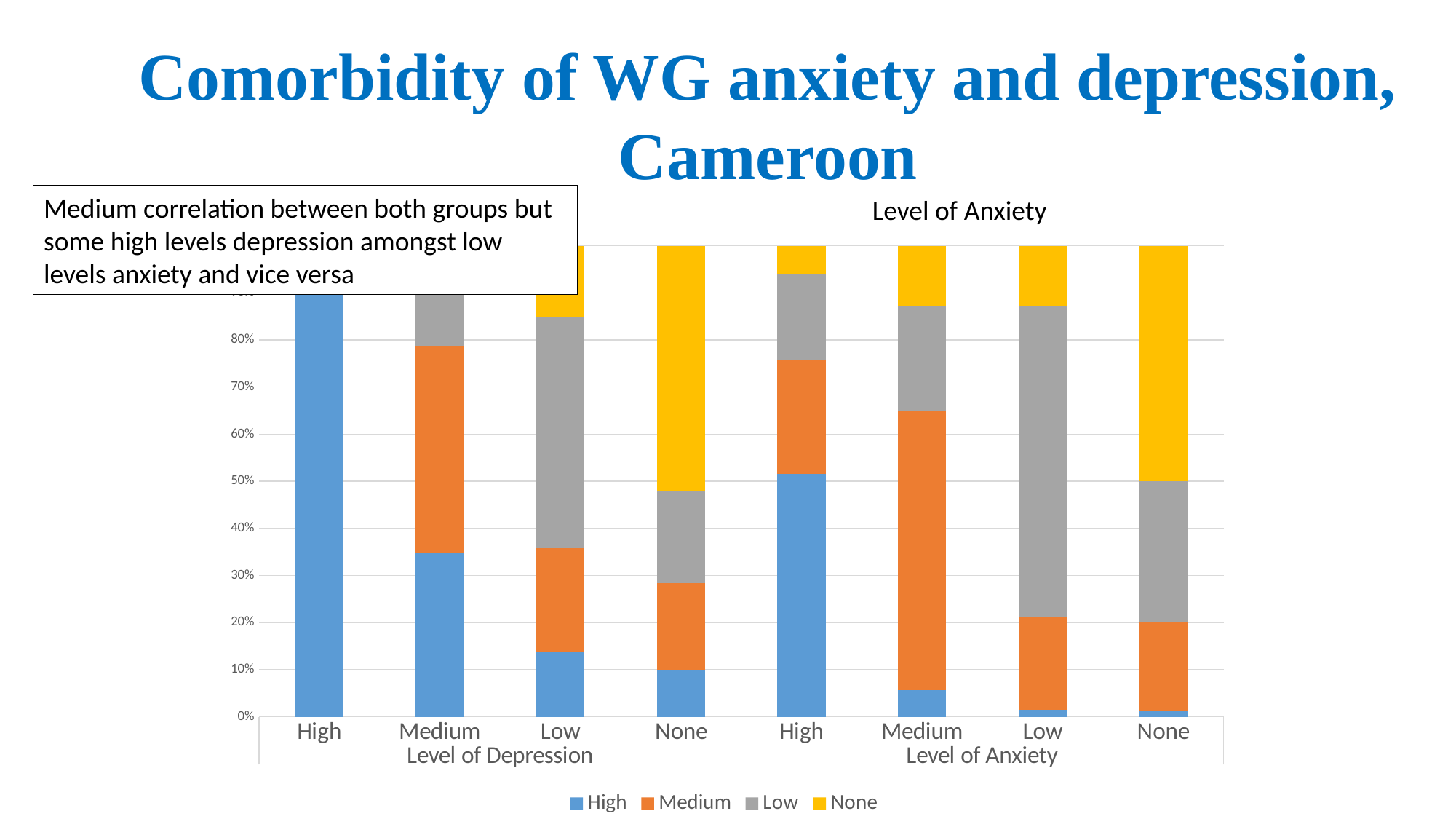
Is the High segment of the Medium bar in the Level of Depression group greater or less than 30%? greater What are the two group labels shown along the x axis? Level of Depression and Level of Anxiety How many series does the legend list? 4 Is the High segment of the Medium bar in the Level of Anxiety group greater or less than 10%? less Is the High segment of the Low bar in the Level of Anxiety group greater or less than 10%? less Which bar has the largest High segment? High (Level of Depression) How many bars are plotted in the chart? 8 Across the Level of Depression group, does the High segment rise or fall from High to None? fall What is the title of the chart? Level of Anxiety Which is larger: the High segment of the High bar in the Level of Depression group or the High segment of the High bar in the Level of Anxiety group? High bar in the Level of Depression group What kind of chart is shown on the slide? Stacked bar chart